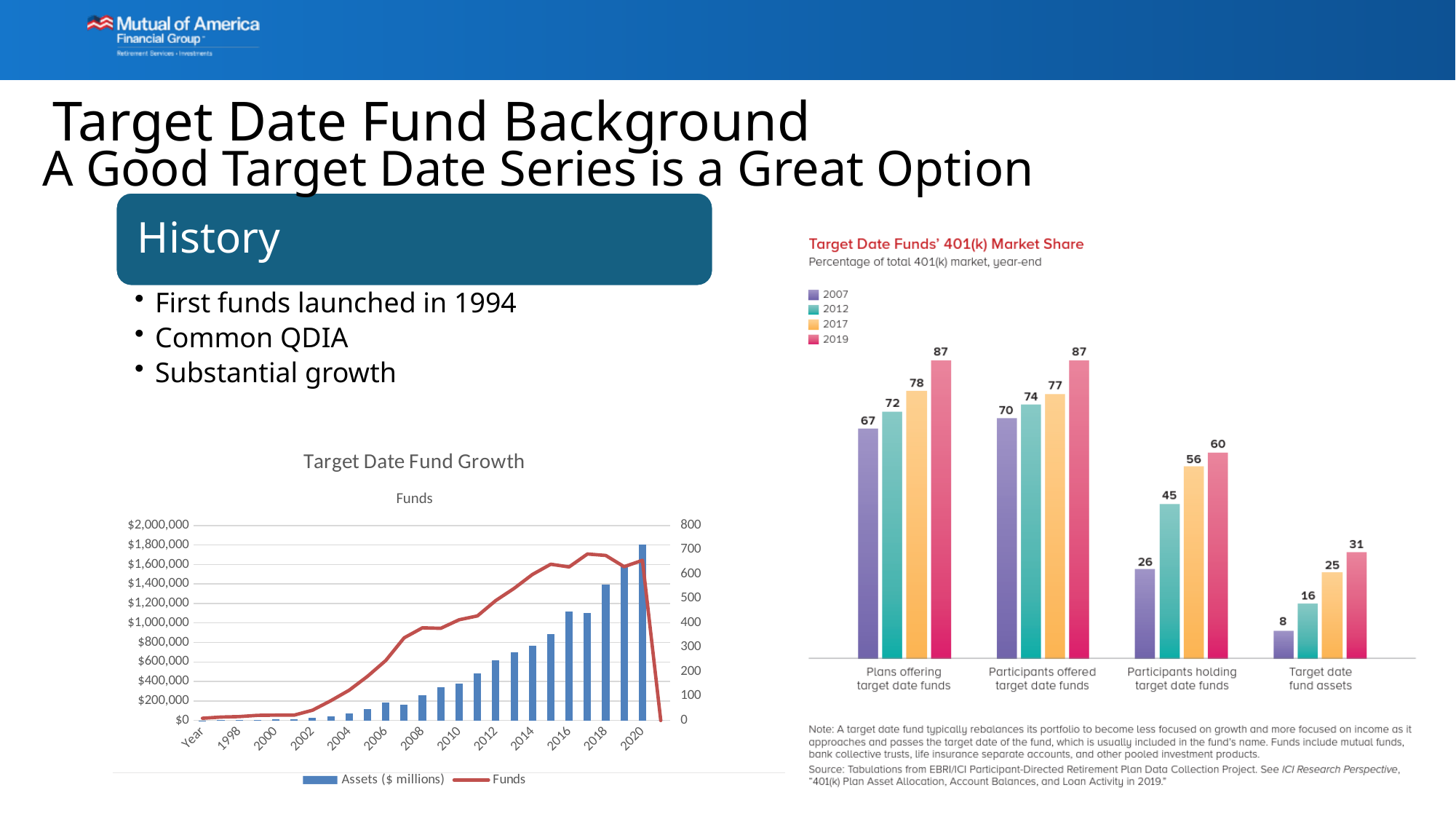
In the Target Date Funds' 401(k) Market Share chart, what is the value for Participants holding target date funds in 2007? 26 In the Target Date Funds' 401(k) Market Share chart, what is the value for Plans offering target date funds in 2019? 87 In the Target Date Funds' 401(k) Market Share chart, do the values for Target date fund assets rise or fall from 2007 to 2019? rise In the Target Date Fund Growth chart, is the Assets ($ millions) bar for 2020 greater or less than $1,600,000? greater In the Target Date Funds' 401(k) Market Share chart, which is larger: the 2012 value for Plans offering target date funds or the 2012 value for Participants holding target date funds? Plans offering target date funds In the Target Date Funds' 401(k) Market Share chart, what is the value for Target date fund assets in 2017? 25 In the Target Date Fund Growth chart, do the Assets ($ millions) bars generally rise or fall from 1998 to 2020? rise In the Target Date Funds' 401(k) Market Share chart, which year has the lowest value for Target date fund assets? 2007 In the Target Date Funds' 401(k) Market Share chart, what is the difference between the 2019 and 2007 values for Participants holding target date funds? 34 How many series does the legend of the Target Date Funds' 401(k) Market Share chart list? 4 How many series does the legend of the Target Date Fund Growth chart list? 2 How many categories are shown on the x axis of the Target Date Funds' 401(k) Market Share chart? 4